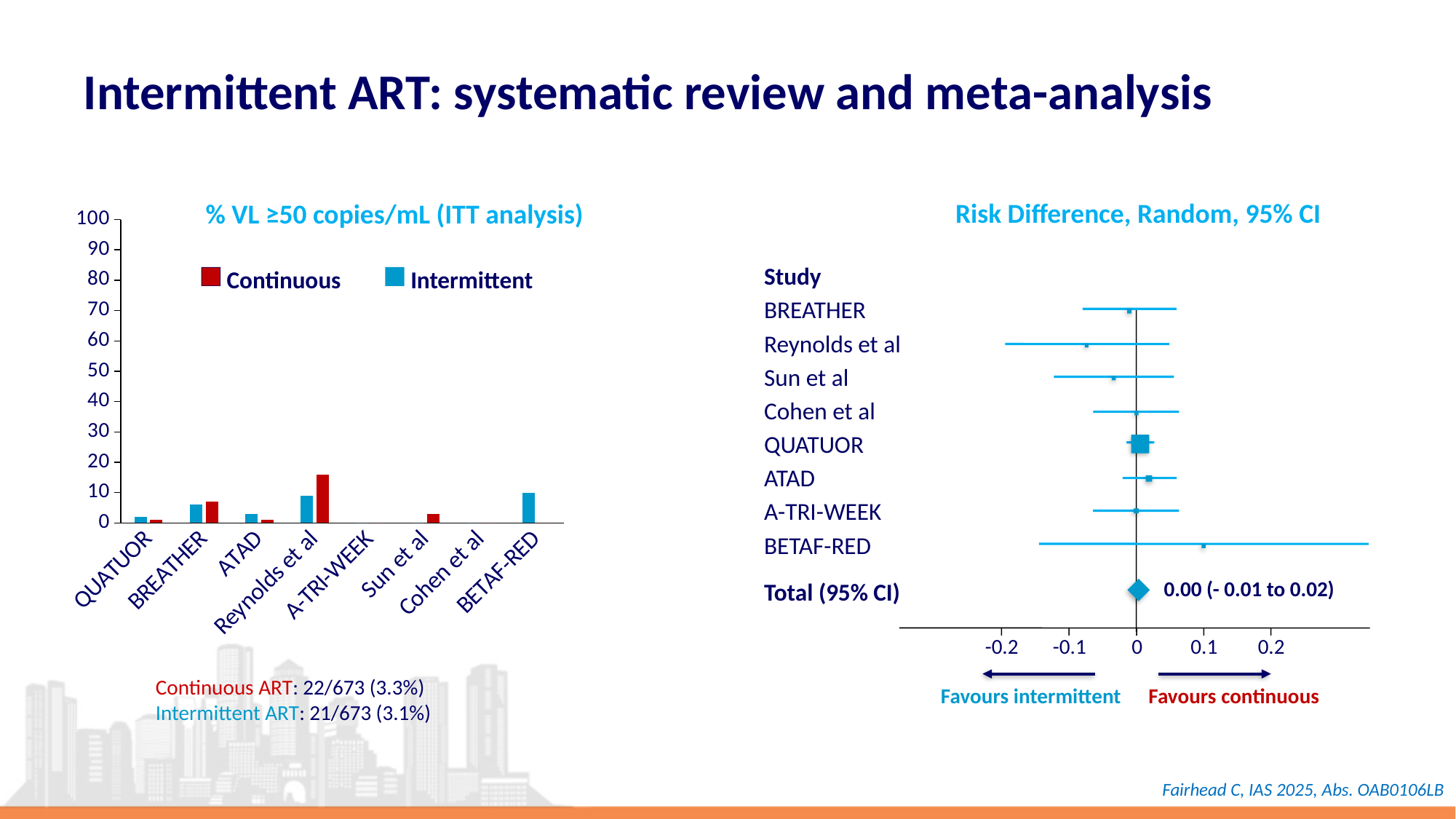
In the left bar chart, which study has the tallest bar? Reynolds et al In the right forest plot, which study has the widest confidence interval? BETAF-RED In the left bar chart, for Reynolds et al, which is larger: the Continuous bar or the Intermittent bar? Continuous In the left bar chart, how many series does the legend list? 2 In the left bar chart, is the Continuous value for Reynolds et al greater or less than 10? greater In the left bar chart, how many studies are shown on the x axis? 8 What kind of chart is the left chart titled '% VL ≥50 copies/mL (ITT analysis)'? bar chart In the left bar chart, which colour represents the Continuous series? red In the right forest plot titled 'Risk Difference, Random, 95% CI', what is the total (95% CI) risk difference? 0.00 (- 0.01 to 0.02) In the left bar chart, is the Intermittent value for BETAF-RED greater or less than 20? less In the right forest plot, how many individual studies are listed? 8 In the right forest plot, which side of the axis is labelled 'Favours continuous'? the right side